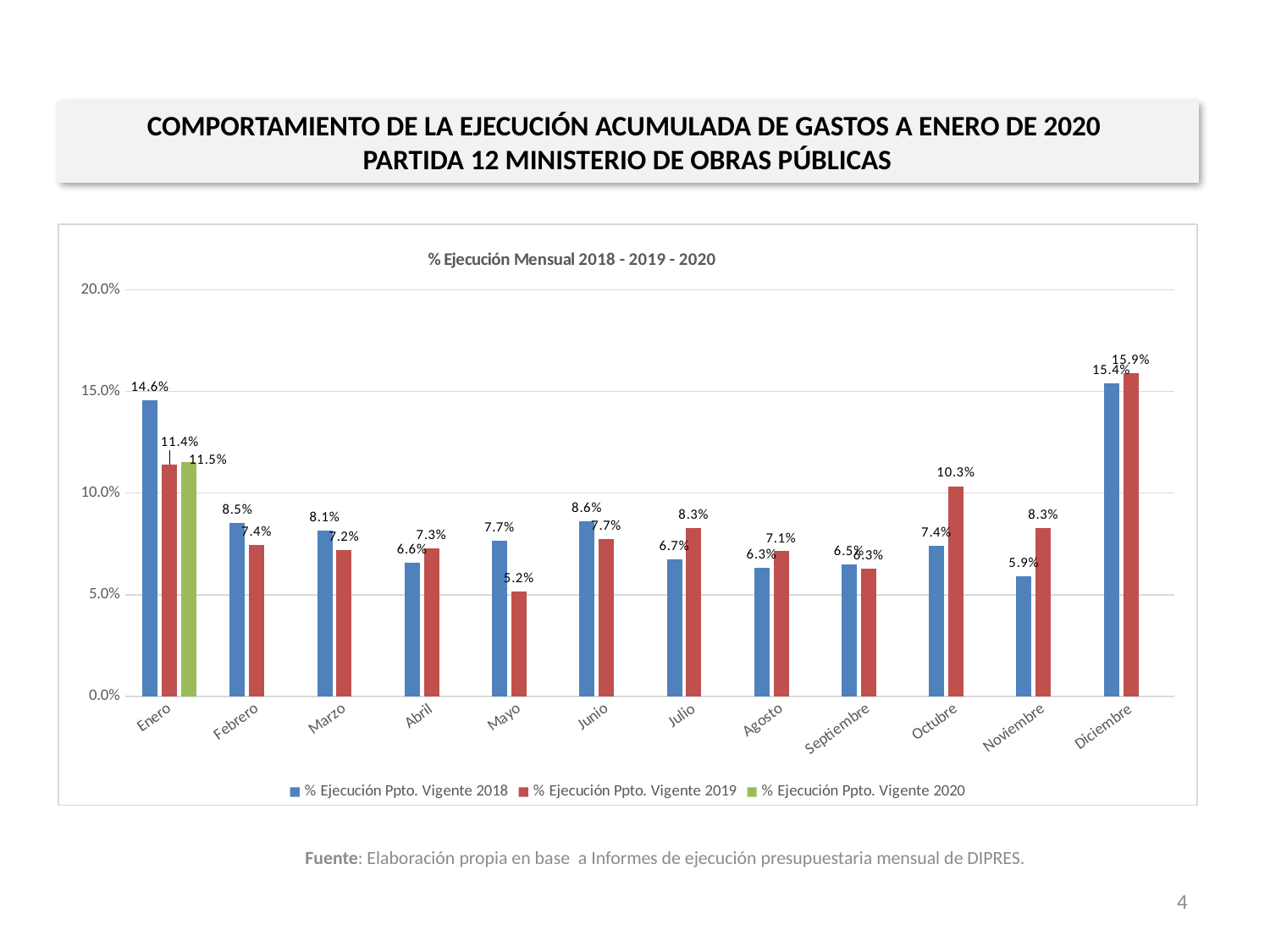
What is the value for % Ejecución Ppto. Vigente 2018 in Noviembre? 5.9% How many months are shown on the x axis? 12 Which is larger in Mayo, the 2018 value or the 2019 value? 2018 (7.7%) What is the value for % Ejecución Ppto. Vigente 2020 in Enero? 11.5% Is the value for % Ejecución Ppto. Vigente 2018 in Diciembre greater or less than 15.0%? greater How many series does the legend list? 3 What is the difference between the 2018 and 2019 values in Enero? 3.2% What is the value for % Ejecución Ppto. Vigente 2019 in Octubre? 10.3% What is the title of the chart? % Ejecución Mensual 2018 - 2019 - 2020 Which month has the lowest value for % Ejecución Ppto. Vigente 2019? Mayo Which month has the highest value for % Ejecución Ppto. Vigente 2019? Diciembre What type of chart is shown on the slide? Bar chart